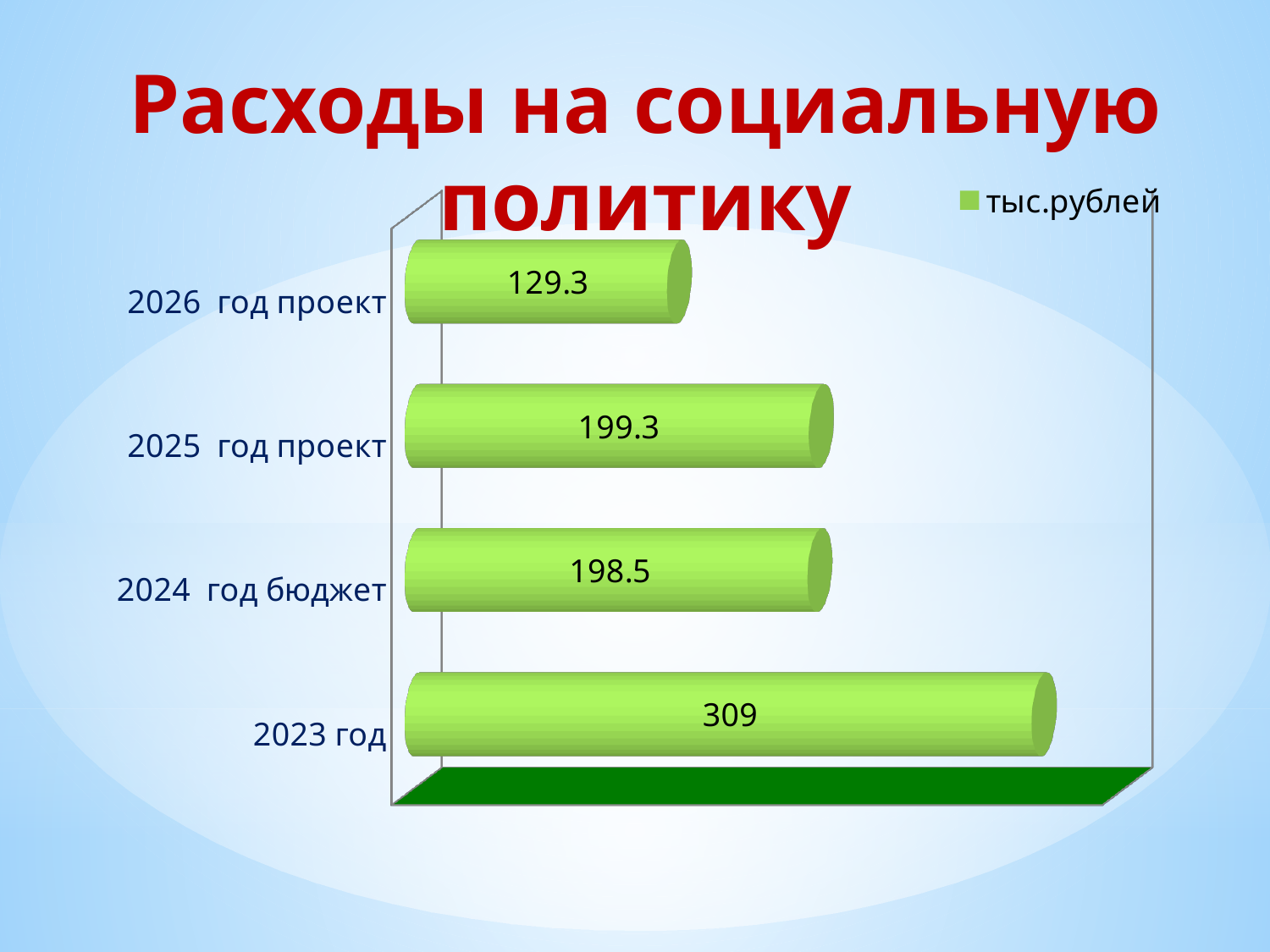
What kind of chart is shown on the slide? Bar chart What is the value for 2023 год? 309 How many categories are shown in the chart? 4 What is the difference between the values for 2023 год and 2026 год проект? 179.7 What is the value for 2024 год бюджет? 198.5 Which category has the highest value? 2023 год What is the difference between the values for 2025 год проект and 2024 год бюджет? 0.8 What is the value for 2025 год проект? 199.3 Which is larger, the value for 2023 год or the value for 2024 год бюджет? 2023 год What is the value for 2026 год проект? 129.3 Which category has the lowest value? 2026 год проект What series name does the legend show? тыс.рублей